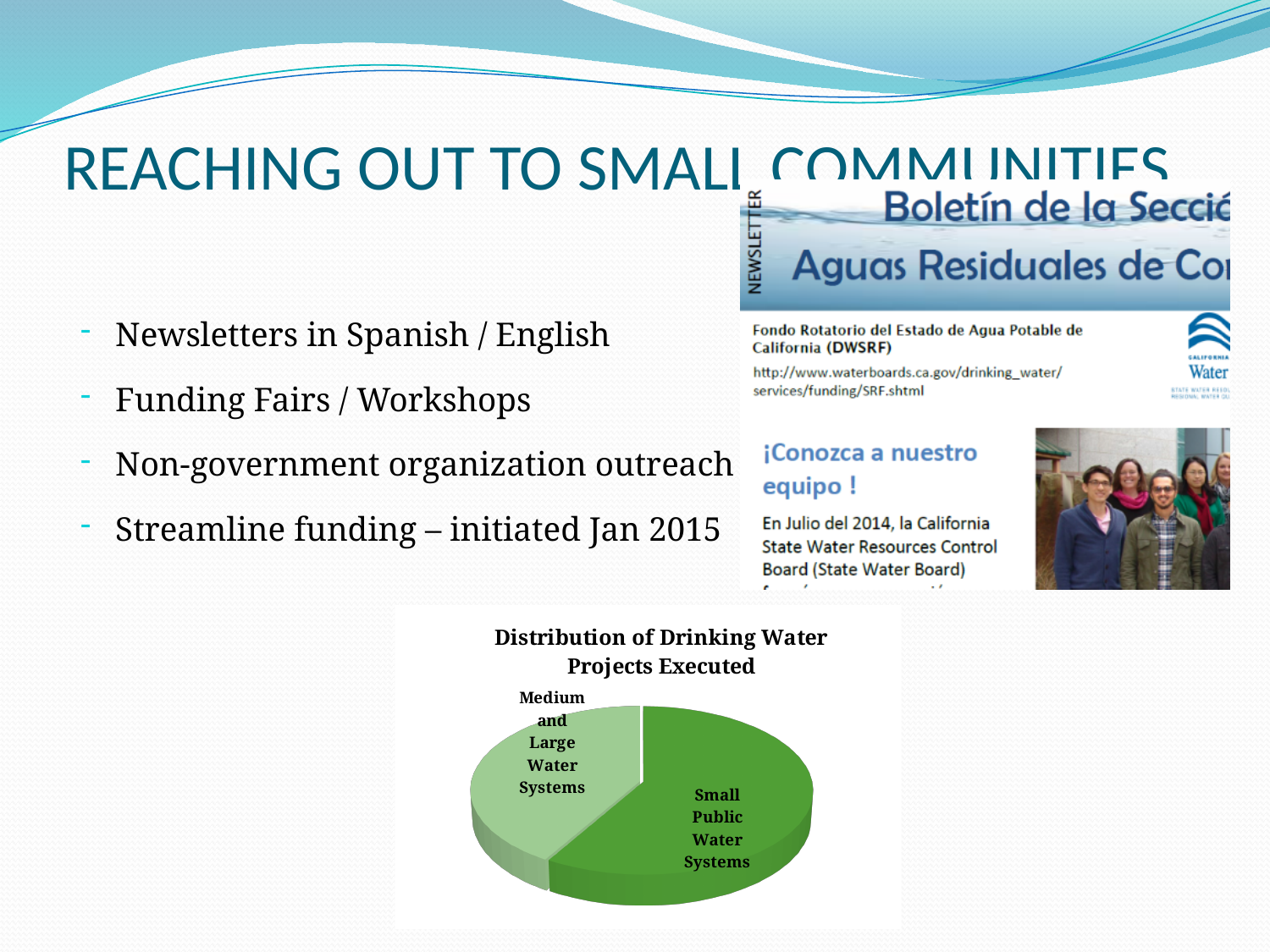
Which slice is larger: Small Public Water Systems or Medium and Large Water Systems? Small Public Water Systems What kind of chart is shown on the slide? Pie chart What colour is the Small Public Water Systems slice in the pie chart? Dark green What is the title of the pie chart? Distribution of Drinking Water Projects Executed How many slices does the pie chart have? 2 Which category has the smallest slice in the pie chart? Medium and Large Water Systems Which category has the largest slice in the pie chart? Small Public Water Systems Does the Small Public Water Systems slice account for more or less than half of the pie? More